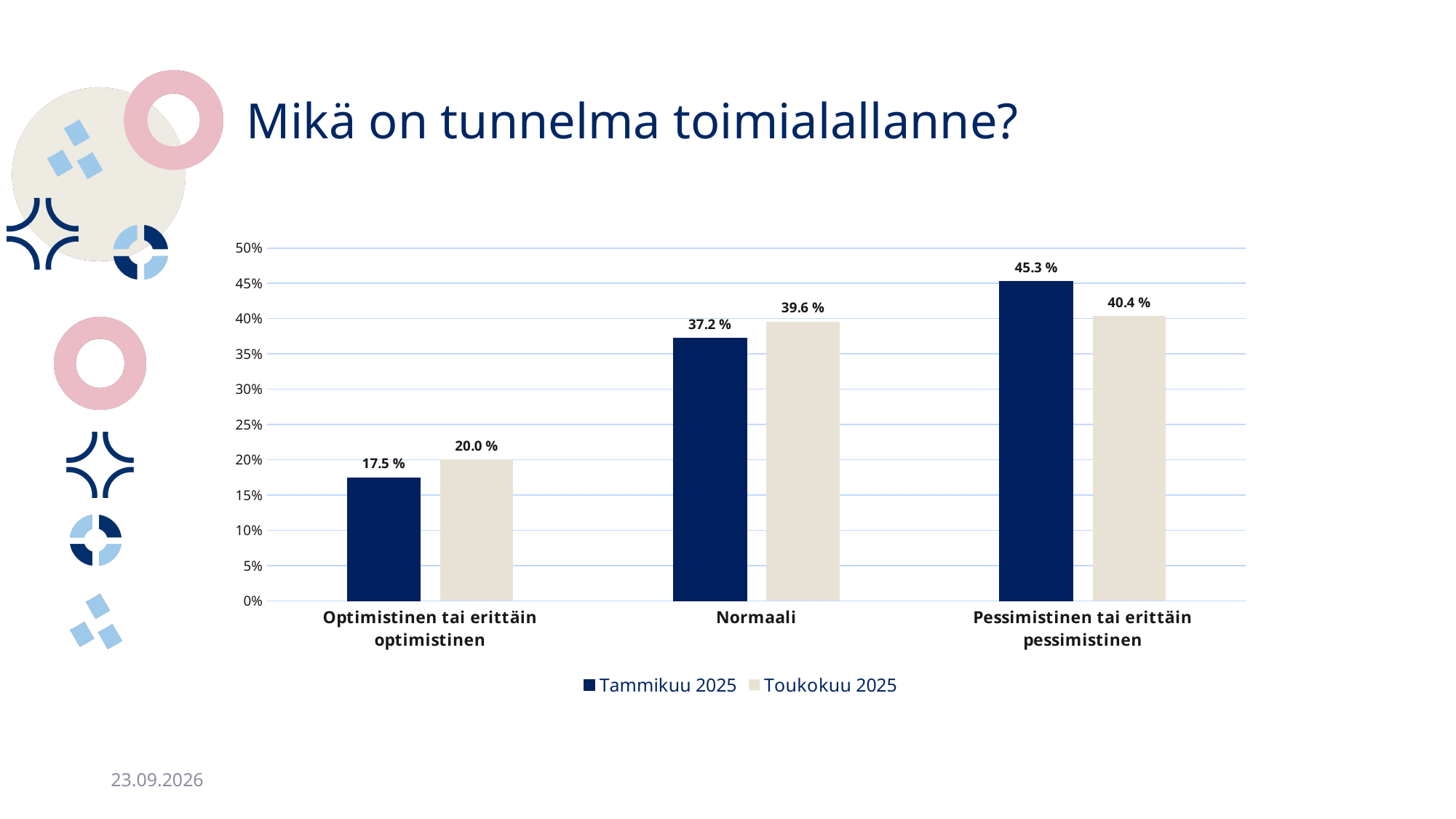
How many series does the legend list? 2 What is the difference between the Tammikuu 2025 and Toukokuu 2025 values for Pessimistinen tai erittäin pessimistinen? 4.9 % What is the title of the chart on the slide? Mikä on tunnelma toimialallanne? Which category has the highest value for Toukokuu 2025? Pessimistinen tai erittäin pessimistinen What is the value for Tammikuu 2025 in the Normaali category? 37.2 % Is the Toukokuu 2025 value for Normaali greater or less than 35%? greater What is the value for Tammikuu 2025 in the Pessimistinen tai erittäin pessimistinen category? 45.3 % How many categories are shown on the x axis? 3 What kind of chart is shown on the slide? bar chart Which is larger in the Normaali category: Tammikuu 2025 or Toukokuu 2025? Toukokuu 2025 What is the value for Toukokuu 2025 in the Optimistinen tai erittäin optimistinen category? 20.0 % Which category has the lowest value for Tammikuu 2025? Optimistinen tai erittäin optimistinen